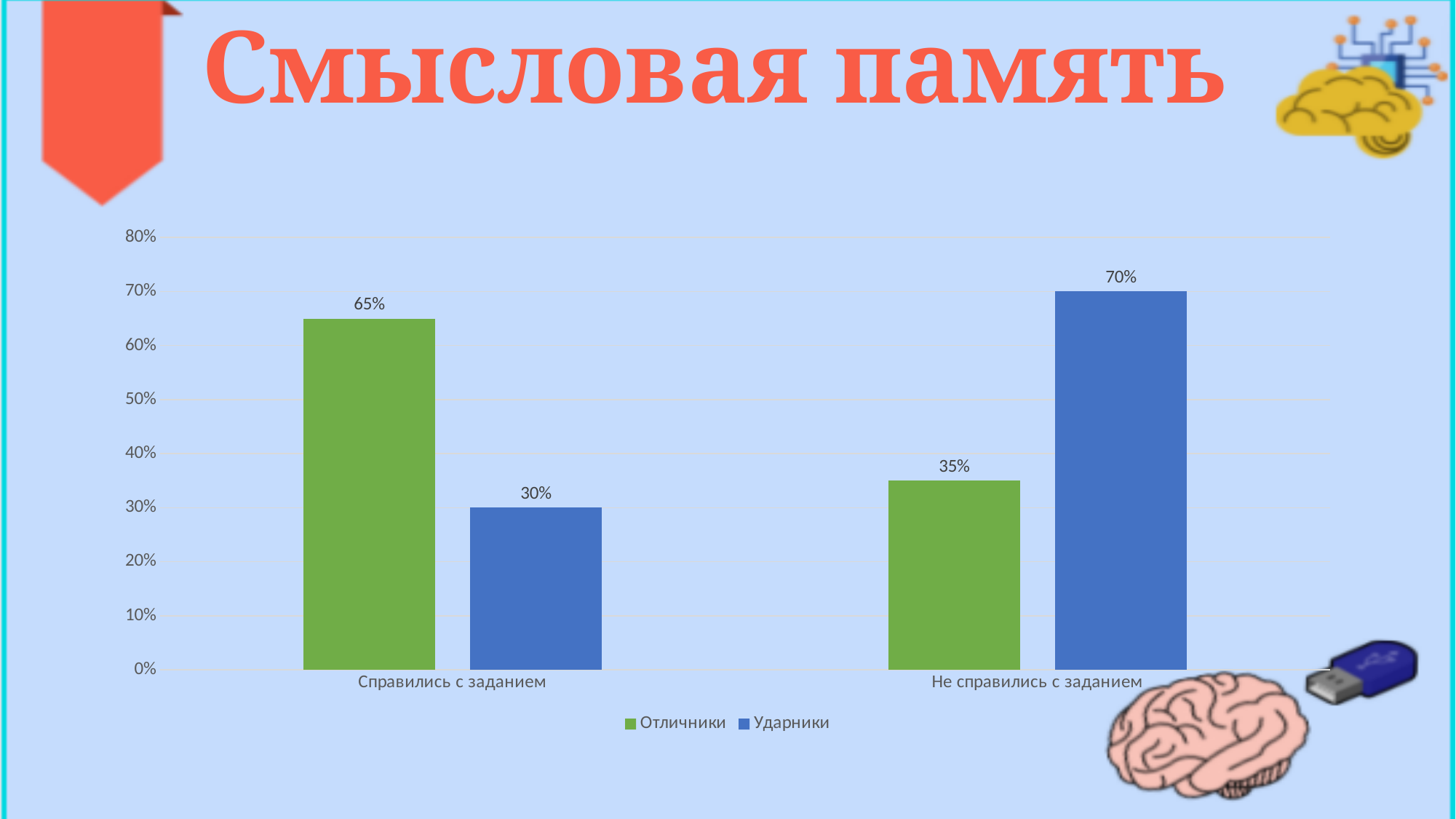
What is the value for Ударники in the Не справились с заданием category? 70% Which series has the lowest value in the Справились с заданием category? Ударники What is the value for Отличники in the Не справились с заданием category? 35% What is the difference between the Отличники and Ударники values in the Справились с заданием category? 35% What kind of chart is shown on the slide? Bar chart How many categories are shown on the x axis? 2 How many series does the legend list? 2 Which is larger: the Отличники value for Справились с заданием or the Ударники value for Не справились с заданием? Ударники value for Не справились с заданием What is the value for Ударники in the Справились с заданием category? 30% What is the value for Отличники in the Справились с заданием category? 65% What is the difference between the Ударники and Отличники values in the Не справились с заданием category? 35% Which series has the highest value in the Не справились с заданием category? Ударники